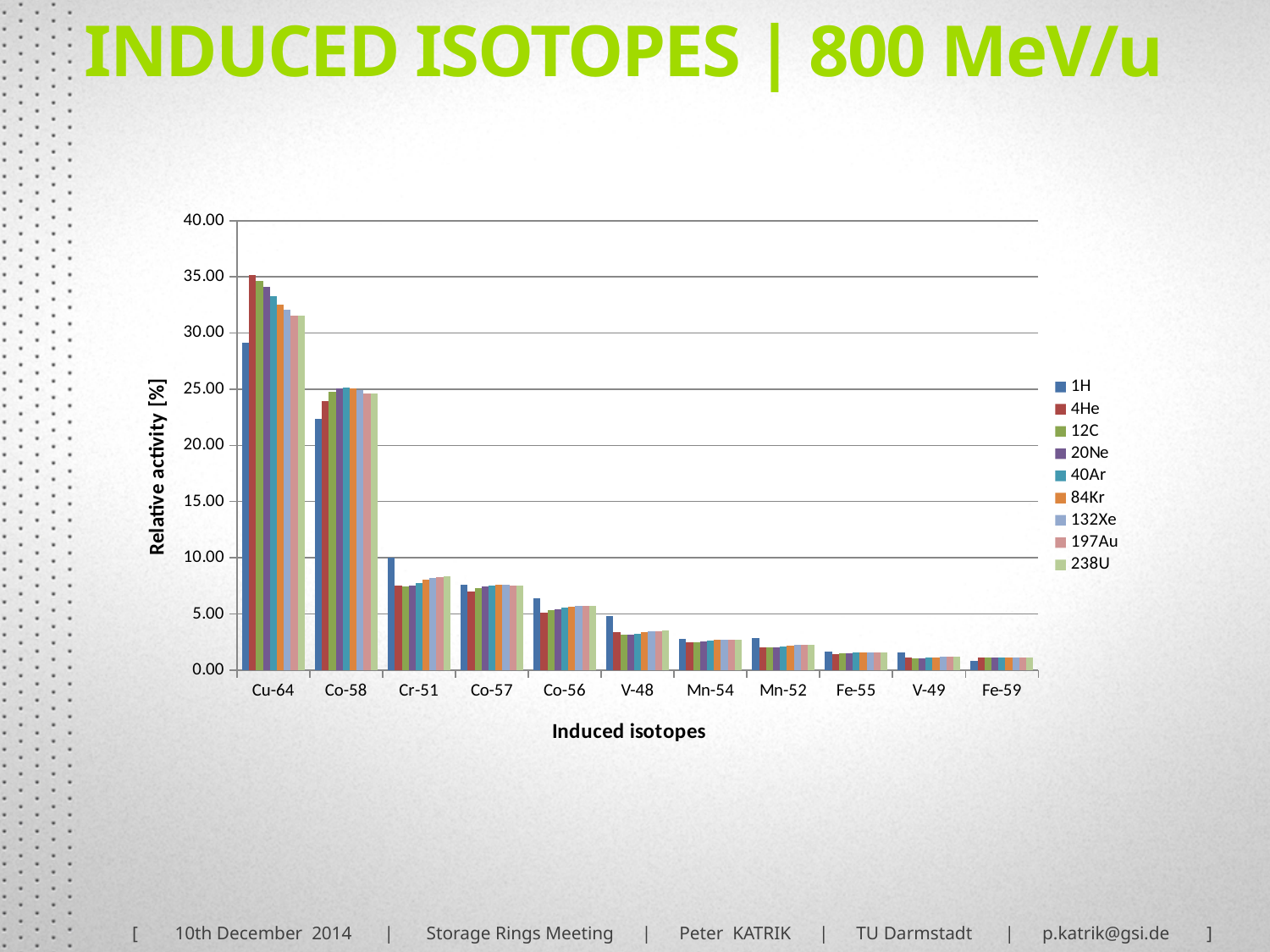
How many series does the legend list? 9 What kind of chart is shown on the slide? bar chart Is the relative activity of Co-58 for the 4He series greater or less than 25.00? less Is the relative activity of Cu-64 for the 1H series greater or less than 25.00? greater How many induced isotopes are shown on the x axis? 11 Is the relative activity of Cr-51 for the 4He series greater or less than 10.00? less For Cu-64, which series has the larger relative activity, 1H or 4He? 4He Do the relative activity values generally rise or fall from left to right along the x axis? fall Which induced isotope has the highest relative activity? Cu-64 What is the label of the y axis? Relative activity [%] For the 1H series, which has the larger relative activity, Cu-64 or Co-58? Cu-64